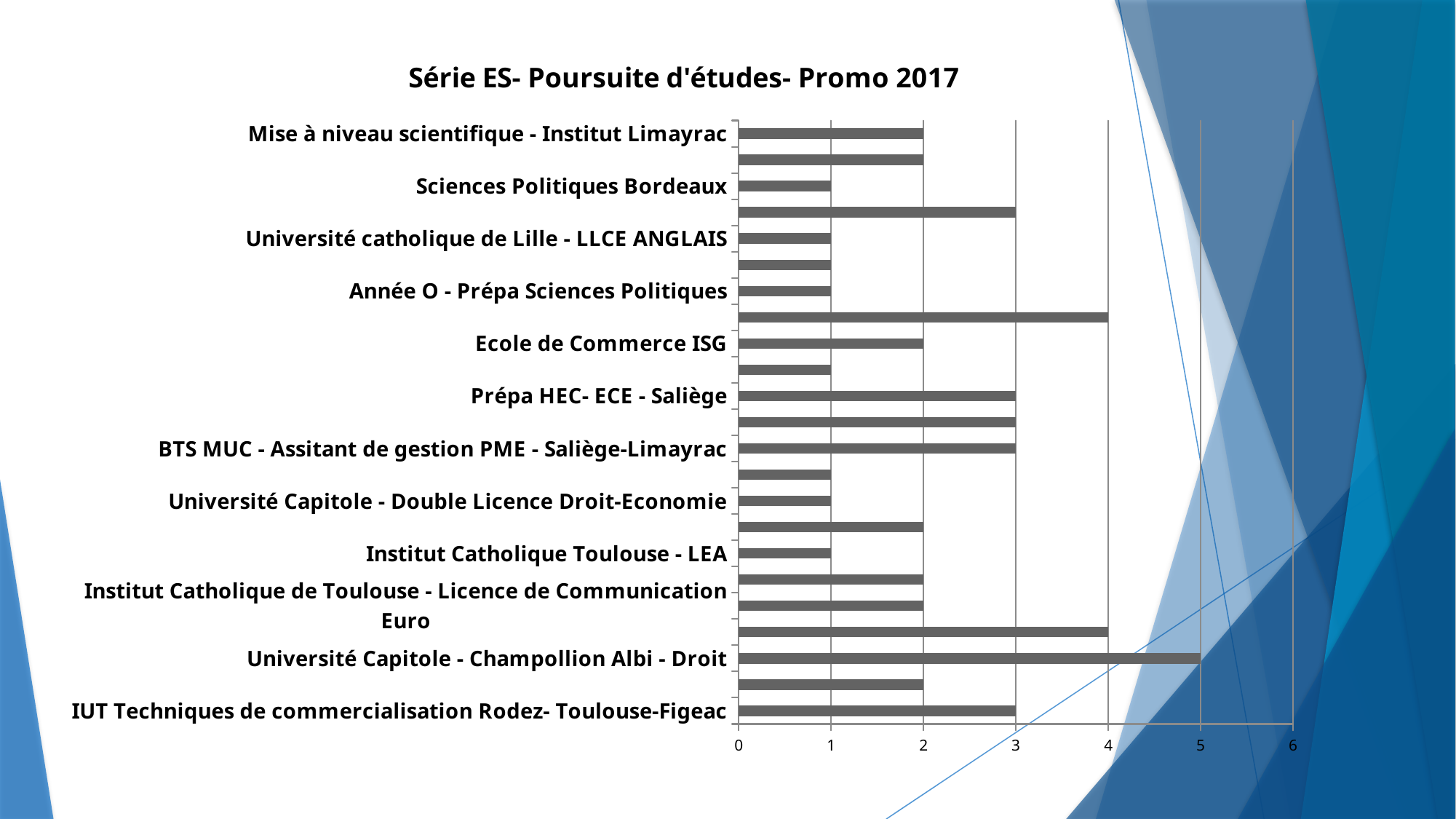
What is the value for Mise à niveau scientifique - Institut Limayrac? 2 What is the value for Ecole de Commerce ISG? 2 What is the value for Sciences Politiques Bordeaux? 1 Is the value for Université Capitole - Champollion Albi - Droit greater or less than 4? greater What is the value for Prépa HEC- ECE - Saliège? 3 Which is larger, the value for Prépa HEC- ECE - Saliège or the value for Sciences Politiques Bordeaux? Prépa HEC- ECE - Saliège What is the difference between the value for Université Capitole - Champollion Albi - Droit and the value for IUT Techniques de commercialisation Rodez- Toulouse-Figeac? 2 What is the title of the chart? Série ES- Poursuite d'études- Promo 2017 What type of chart is shown on the slide? bar chart What is the value for Université Capitole - Champollion Albi - Droit? 5 Which labeled category has the highest value? Université Capitole - Champollion Albi - Droit What is the value for IUT Techniques de commercialisation Rodez- Toulouse-Figeac? 3